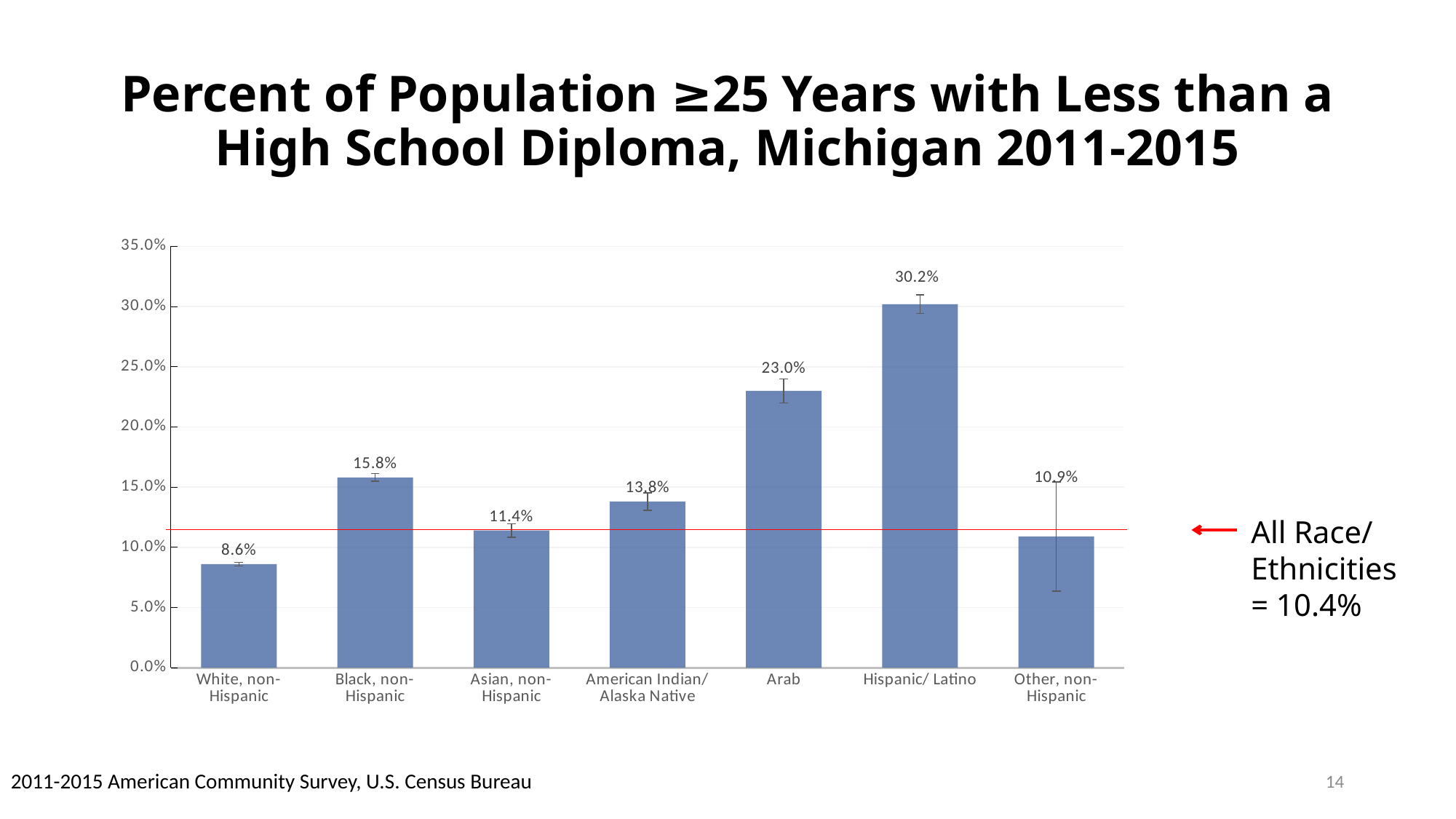
Which is larger, the value for Asian, non-Hispanic or the value for Other, non-Hispanic? Asian, non-Hispanic What is the value for Hispanic/ Latino? 30.2% What is the value for American Indian/ Alaska Native? 13.8% What is the value for Arab? 23.0% What is the value for White, non-Hispanic? 8.6% Which category has the highest value? Hispanic/ Latino What is the difference between the values for Black, non-Hispanic and White, non-Hispanic? 7.2% What is the difference between the values for Hispanic/ Latino and Arab? 7.2% What value does the horizontal reference line for All Race/Ethnicities represent? 10.4% How many categories are shown on the x axis? 7 Which category has the lowest value? White, non-Hispanic What kind of chart is shown on the slide? Bar chart